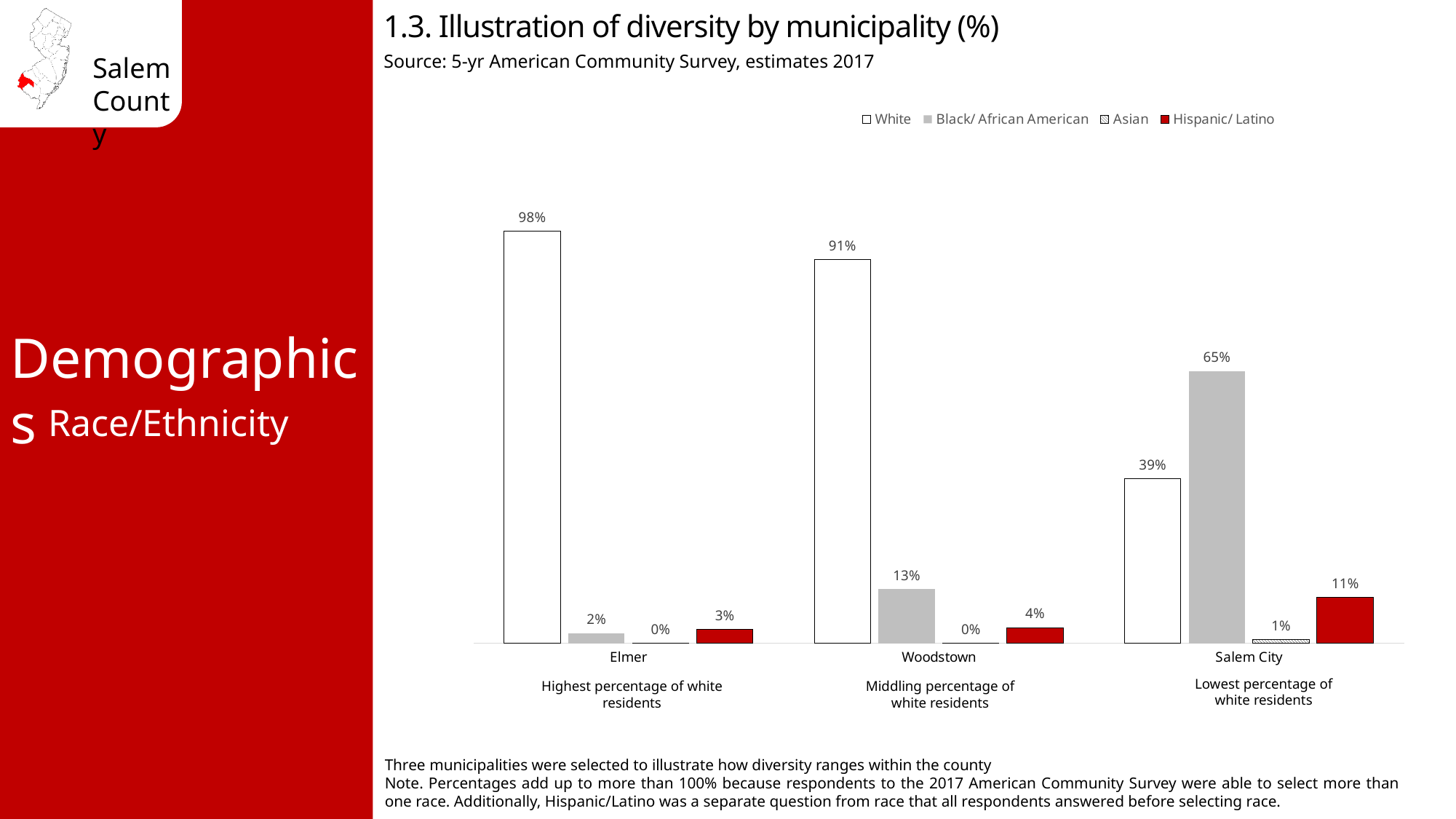
How many municipalities are shown on the x axis? 3 What is the White percentage for Elmer? 98% What is the difference between the White percentage for Elmer and the White percentage for Salem City? 59% How many series does the legend list? 4 What is the Black/ African American percentage for Salem City? 65% What is the Hispanic/ Latino percentage for Woodstown? 4% Which municipality has the highest White percentage? Elmer Which series is drawn in red? Hispanic/ Latino Which is larger in Salem City, the White percentage or the Black/ African American percentage? Black/ African American What is the Asian percentage for Salem City? 1% What kind of chart is shown on the slide? Bar chart Which municipality has the lowest Hispanic/ Latino percentage? Elmer